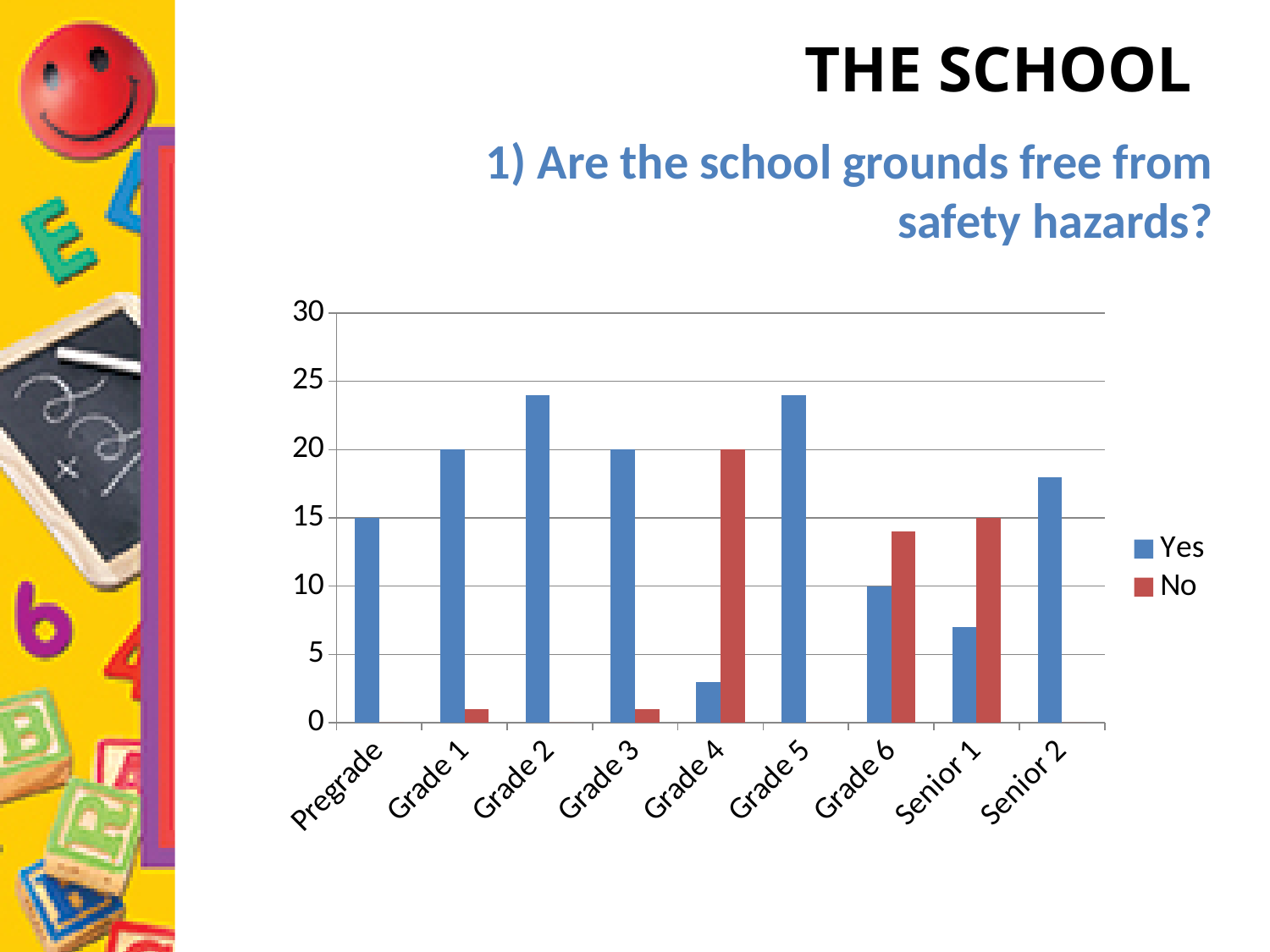
For Senior 1, which is larger, the Yes value or the No value? No Is the Yes value for Grade 2 greater or less than 20? greater How many series does the legend list? 2 Which category has the highest No value? Grade 4 Is the Yes value for Senior 1 greater or less than 10? less What is the No value for Grade 4? 20 What is the Yes value for Pregrade? 15 What kind of chart is shown on the slide? bar chart What is the Yes value for Grade 1? 20 Which category has the lowest Yes value? Grade 4 What is the Yes value for Grade 6? 10 How many grade categories are shown on the x axis? 9